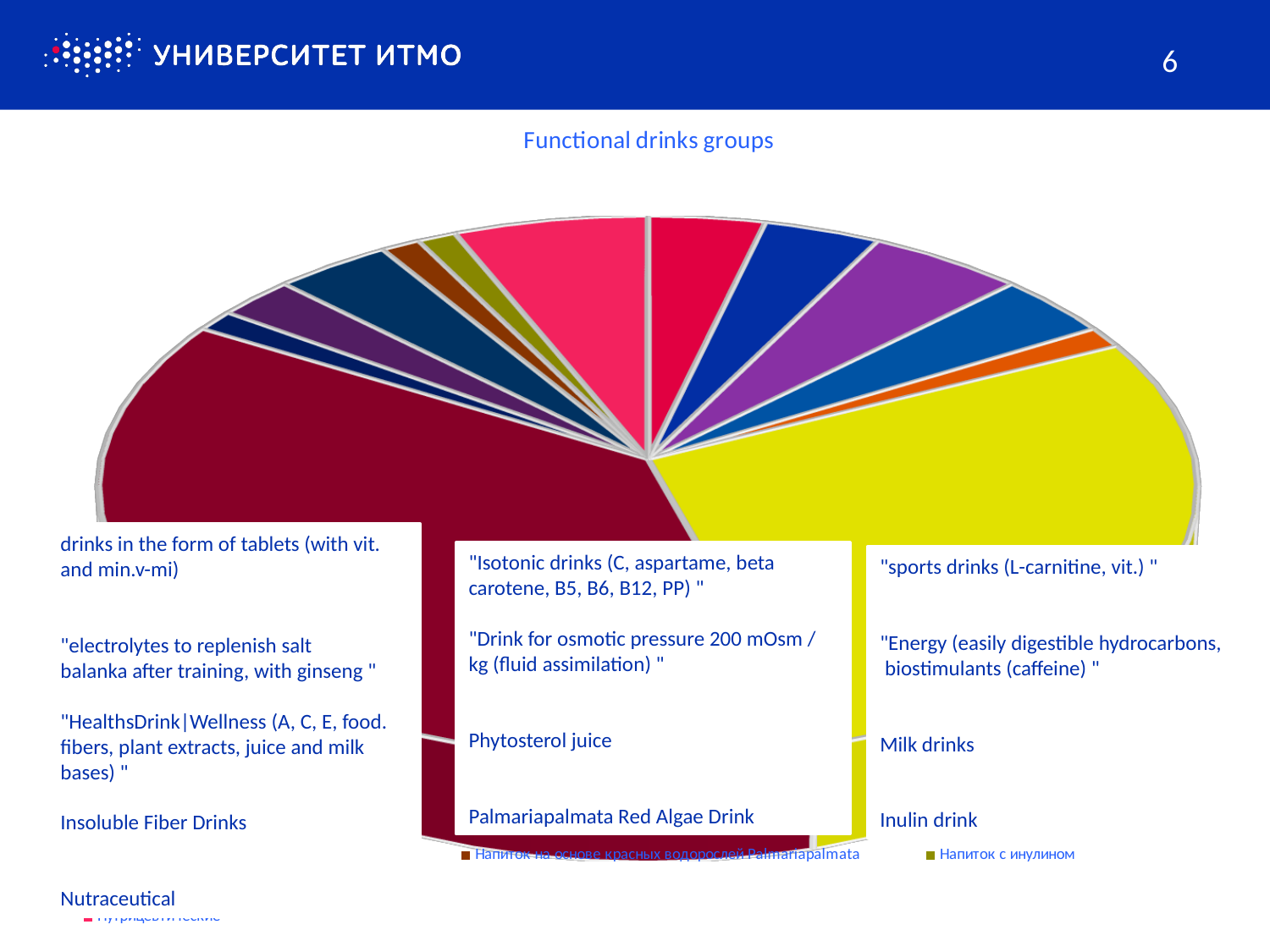
Which is larger, the dark red slice or the orange slice of the pie? the dark red slice What is the title of the chart? Functional drinks groups Which is larger, the yellow slice or the olive-green slice of the pie? the yellow slice Which colour is used in the legend for the Palmariapalmata red algae drink (Напиток на основе красных водорослей Palmariapalmata)? brown What kind of chart is shown on the slide? pie chart